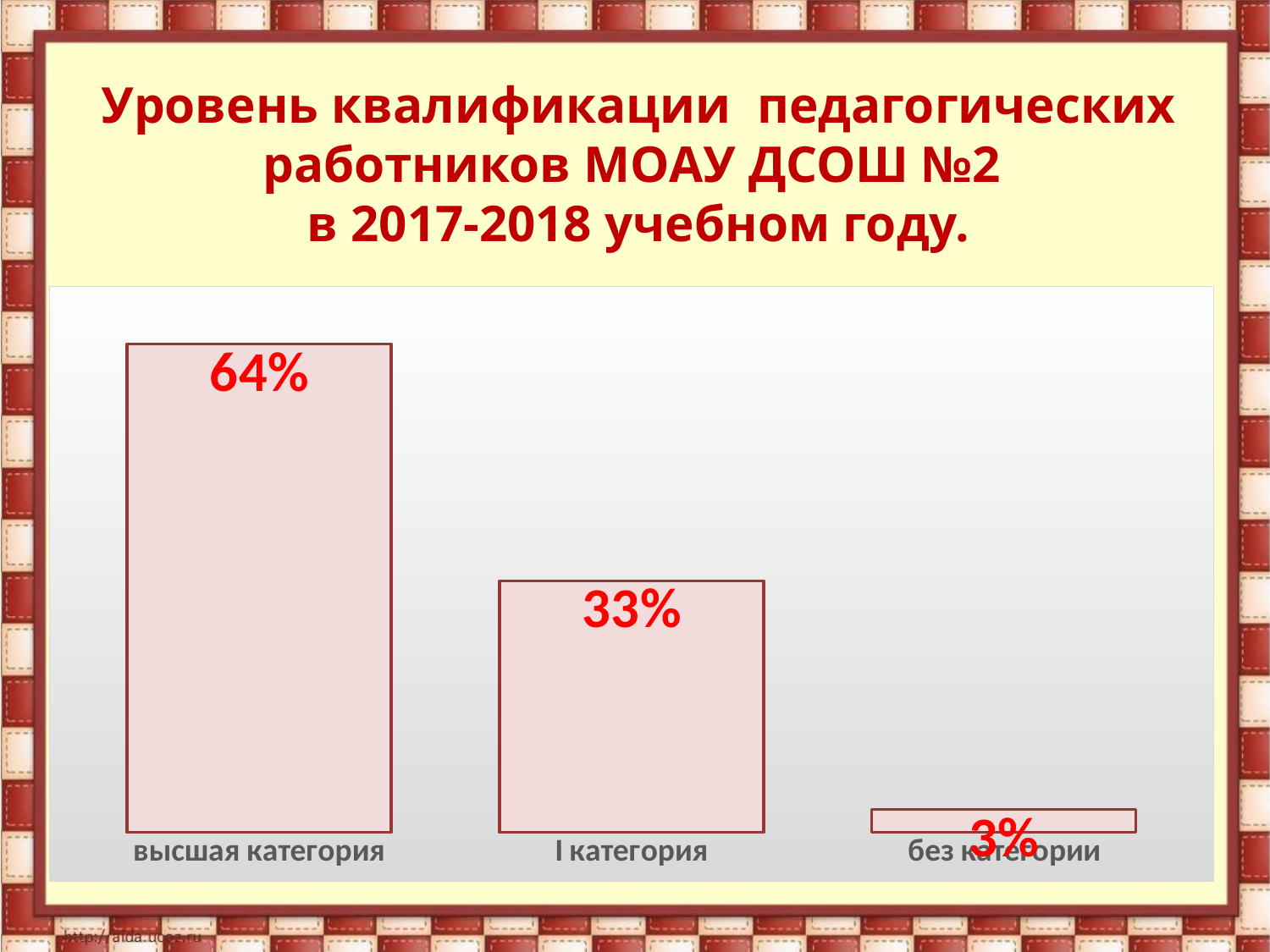
Which is larger, the value for высшая категория or the value for I категория? высшая категория What school year does the chart title refer to? 2017-2018 How many categories are shown in the chart? 3 What is the value for без категории? 3% Which category has the lowest value? без категории What is the value for высшая категория? 64% Which category has the highest value? высшая категория What is the value for I категория? 33% What is the difference between the values for высшая категория and I категория? 31% What is the difference between the values for I категория and без категории? 30% What kind of chart is shown on the slide? bar chart Do the values rise or fall from left to right across the categories? fall